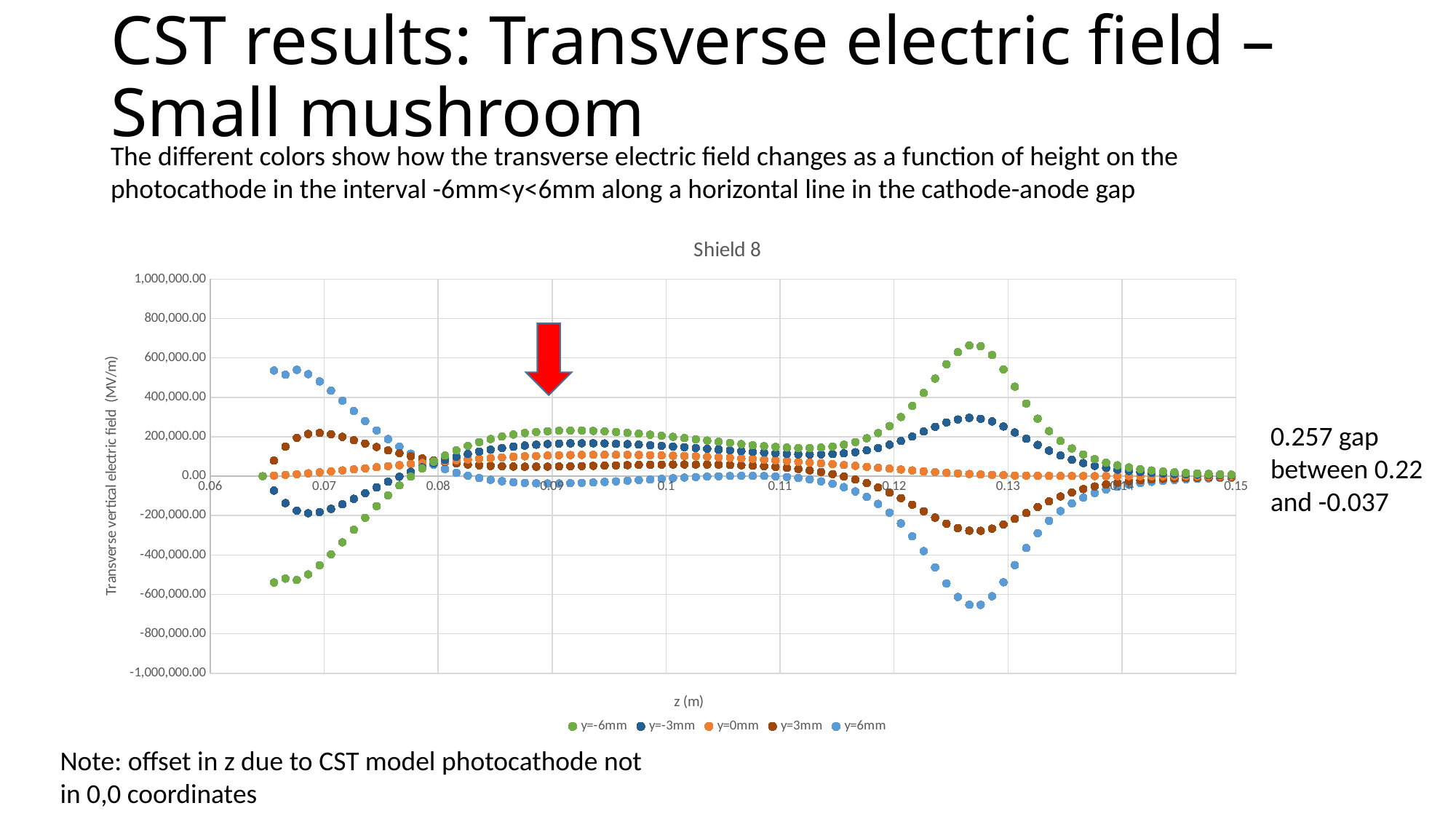
Between z = 0.07 and z = 0.08, do the values of the y=-6mm series rise or fall? rise Is the minimum value of the y=3mm series near z = 0.127 greater or less than -200,000.00? less Is the value of the y=6mm series at its peak near z = 0.067 greater or less than 400,000.00? greater Is the lowest value of the y=6mm series near z = 0.127 greater or less than -600,000.00? less What is the label of the horizontal axis of the chart? z (m) What kind of chart is shown on the slide? scatter chart Which series has the highest value at z = 0.127? y=-6mm Which series has the lowest value at z = 0.127? y=6mm What is the title of the chart? Shield 8 How many series does the legend of the Shield 8 chart list? 5